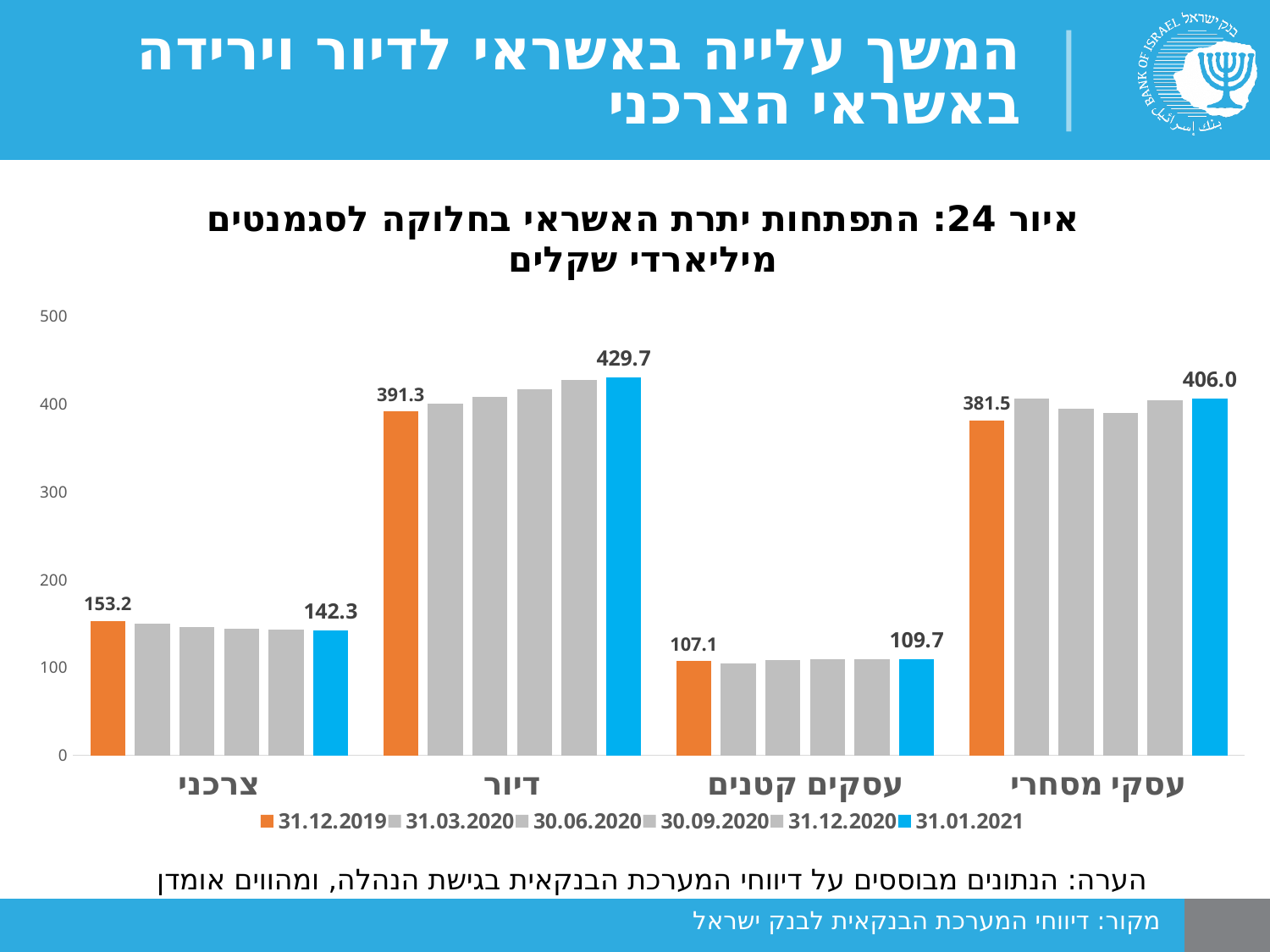
What is the value for צרכני in the 31.12.2019 series? 153.2 Which is larger for צרכני: the 31.12.2019 value or the 31.01.2021 value? 31.12.2019 How many series does the legend list? 6 Is the 30.06.2020 value for עסקי מסחרי greater or less than 300? greater What kind of chart is shown on the slide? bar chart Which category has the highest value in the 31.01.2021 series? דיור What is the value for דיור in the 31.01.2021 series? 429.7 What is the value for עסקי מסחרי in the 31.01.2021 series? 406.0 What is the difference between the 31.01.2021 and 31.12.2019 values for דיור? 38.4 What is the value for עסקים קטנים in the 31.12.2019 series? 107.1 How many categories are shown on the x axis? 4 Which category has the lowest value in the 31.12.2019 series? עסקים קטנים